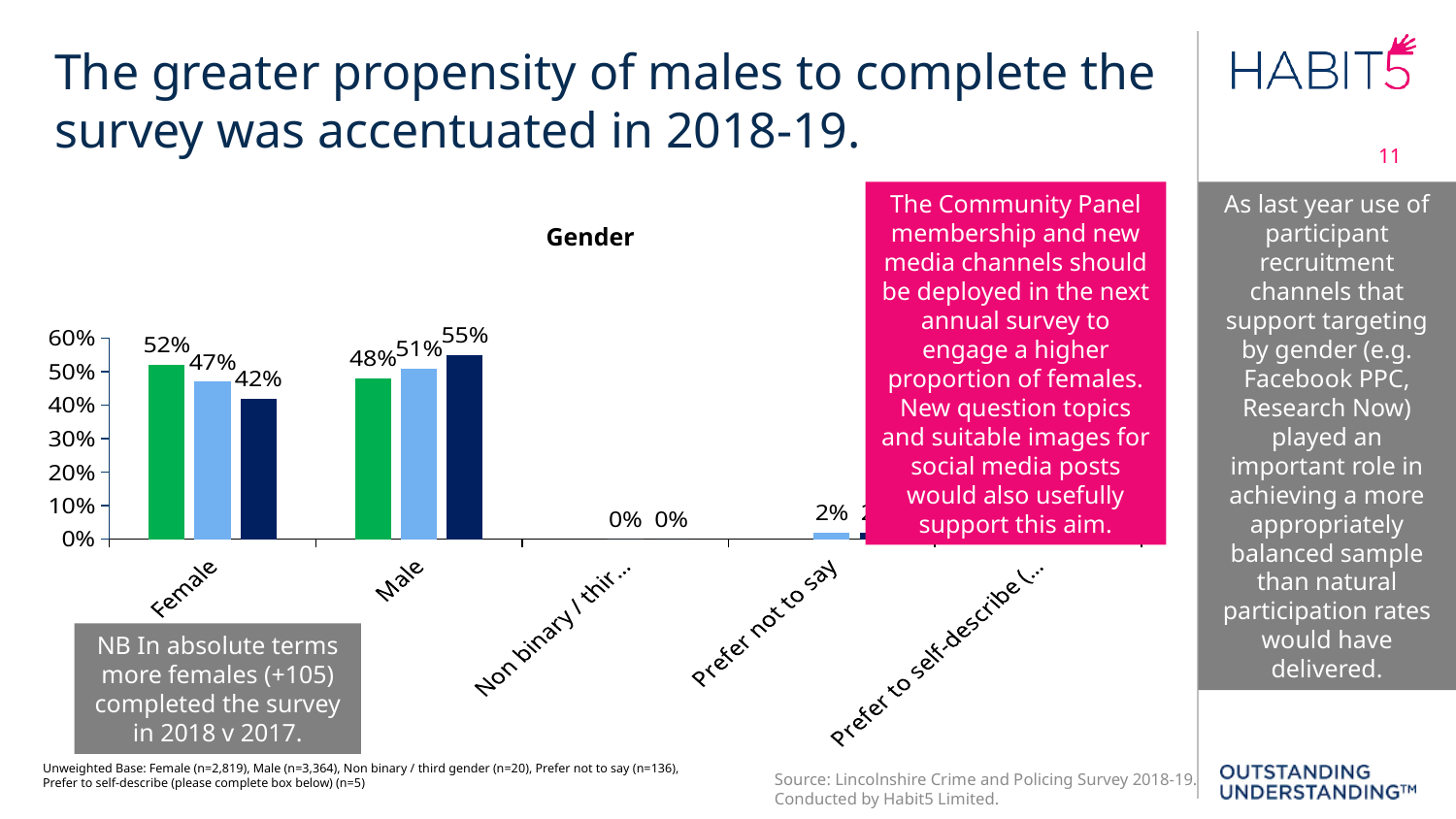
How many categories are shown on the x axis of the Gender chart? 5 What type of chart is shown on the slide? bar chart What is the value of the light blue (second) bar for Female in the Gender chart? 47% In the Gender chart, do the three bars for Male rise or fall from the first (green) to the third (dark blue)? rise In the Gender chart, what is the difference between the green bar (52%) and the dark blue bar (42%) for Female? 10 percentage points In the Gender chart, which category has the higher green (first) bar, Female or Male? Female In the Gender chart, what is the difference between the dark blue bar (55%) and the green bar (48%) for Male? 7 percentage points What is the value of the dark blue (third) bar for Male in the Gender chart? 55% What is the value of the green (first) bar for Female in the Gender chart? 52% In the Gender chart, which category has the higher dark blue (third) bar, Female or Male? Male What is the value of the green (first) bar for Male in the Gender chart? 48% What is the value of the dark blue (third) bar for Female in the Gender chart? 42%